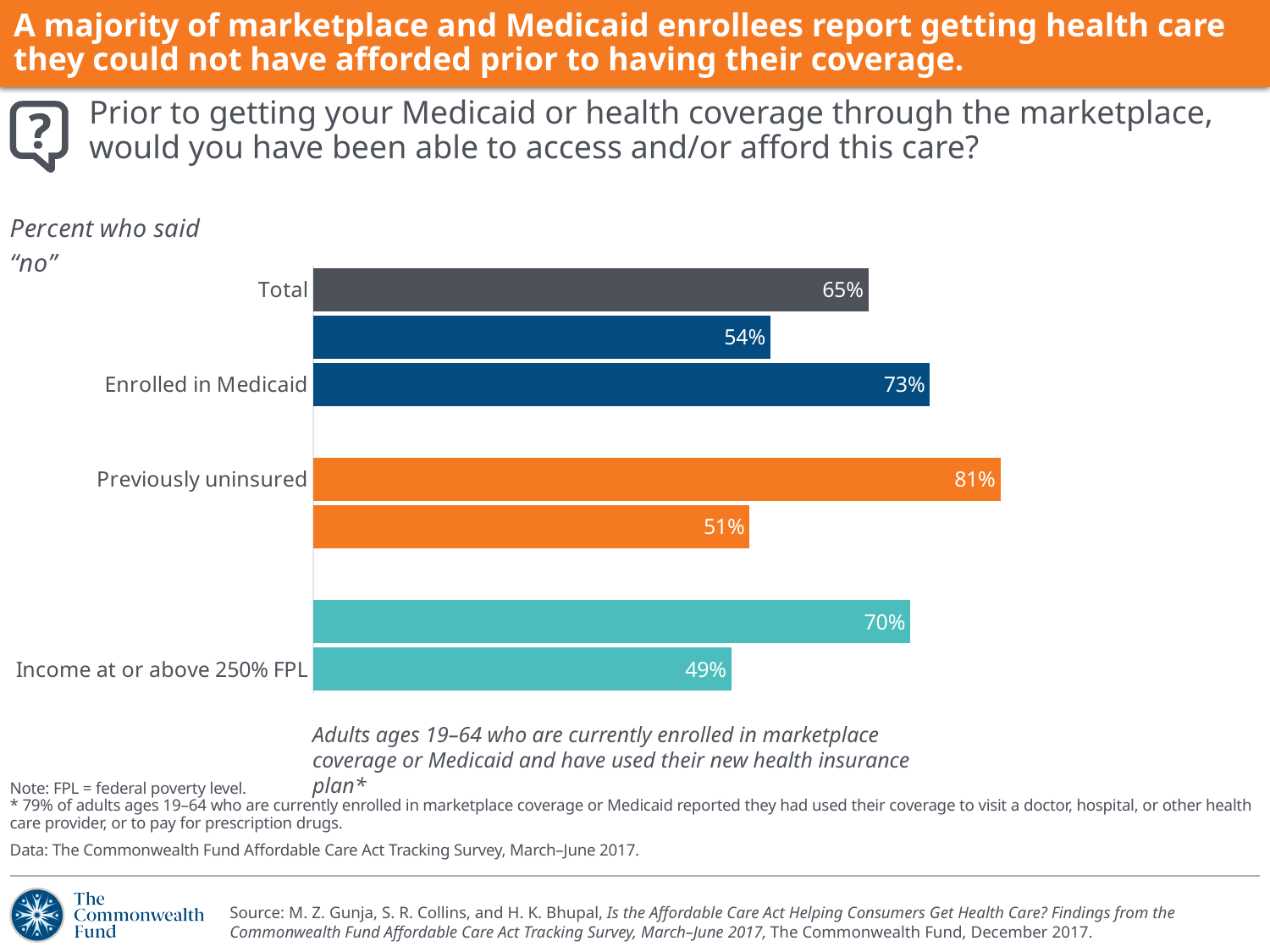
What colour is the bar for Previously uninsured? Orange How many bars are plotted in the chart? 7 What kind of chart is shown on the slide? Bar chart Which labeled category has the lowest value? Income at or above 250% FPL What is the value for Income at or above 250% FPL? 49% Which is larger, the value for Enrolled in Medicaid or the value for Total? Enrolled in Medicaid What is the value for Total? 65% What is the value for Previously uninsured? 81% What is the difference between the values for Enrolled in Medicaid and Income at or above 250% FPL? 24 percentage points What percent of those enrolled in Medicaid said "no"? 73% Which labeled category has the highest value? Previously uninsured What is the difference between the values for Previously uninsured and Total? 16 percentage points